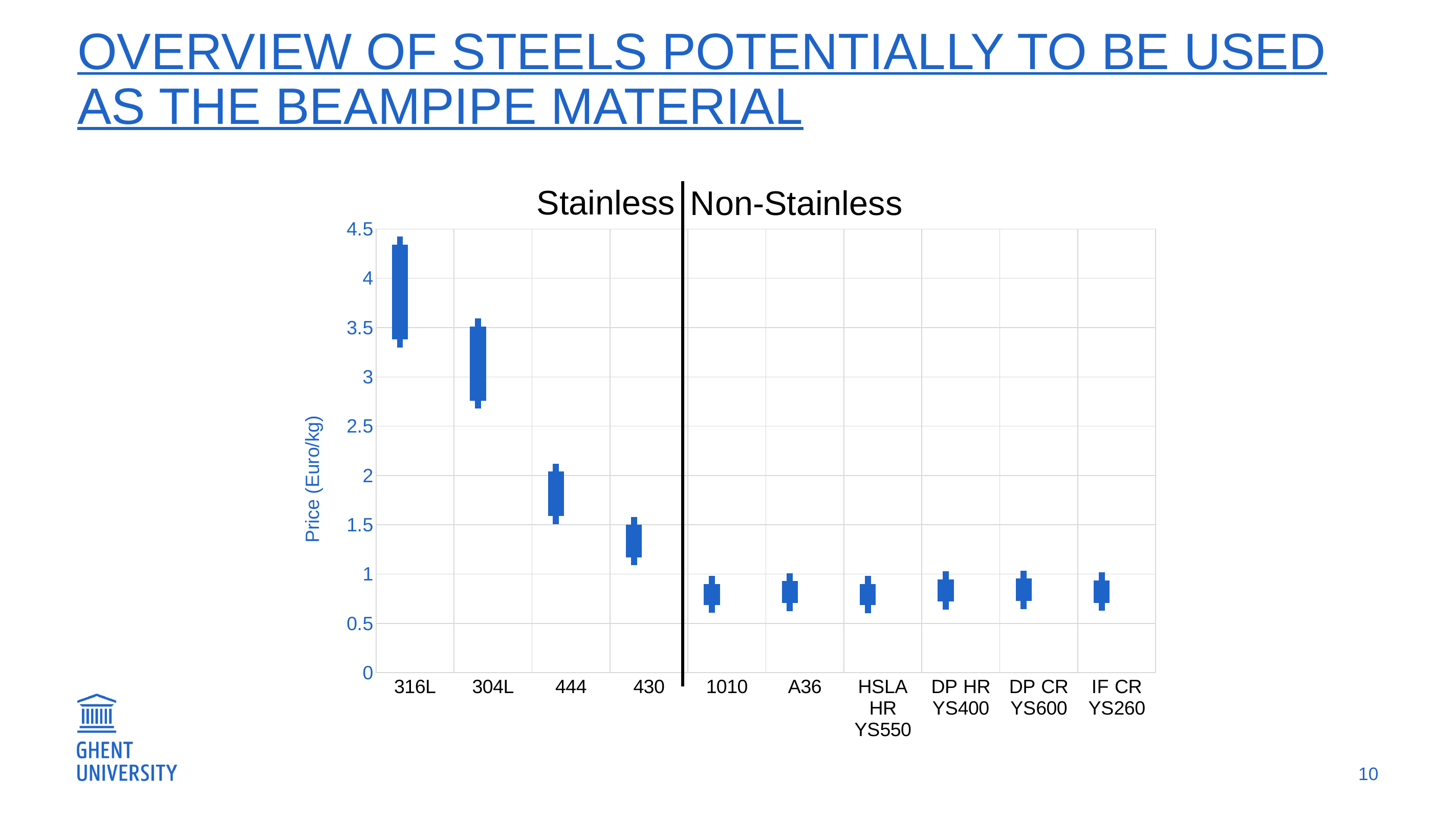
Is the price for 1010 greater or less than 1.5 Euro/kg? less Among the stainless steels, which grade has the lowest price range? 430 Is the price for 316L greater or less than 3 Euro/kg? greater Which steel grade has the highest price range in the chart? 316L How many steel grades are shown on the x axis of the chart? 10 Which has the higher price range, 316L or 304L? 316L Is the price for 304L greater or less than 2.5 Euro/kg? greater Which has the higher price range, 444 or 430? 444 What is the label of the y axis of the chart? Price (Euro/kg) How many steel grades are in the Non-Stainless group of the chart? 6